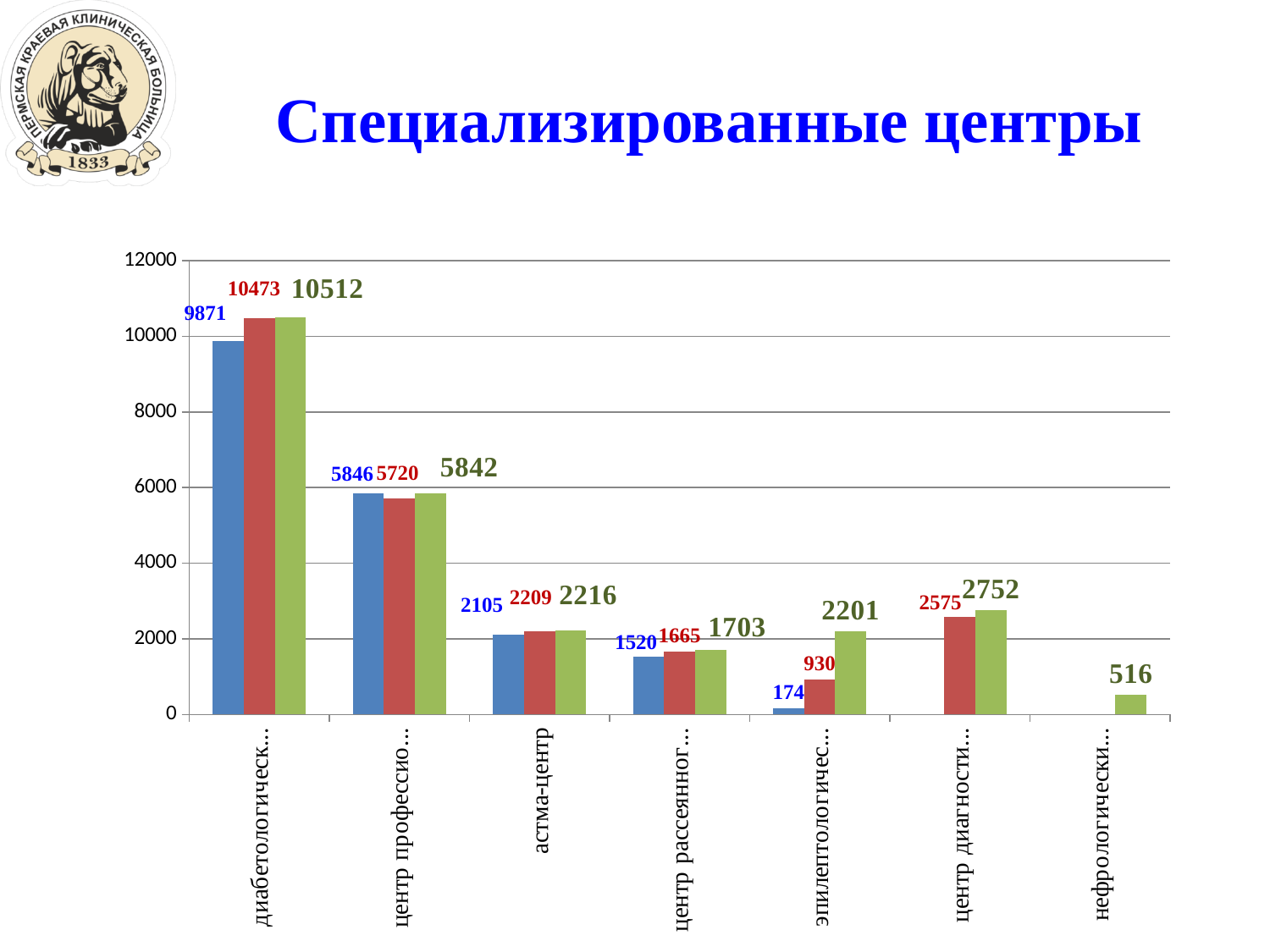
How many categories are shown along the x axis of the chart? 7 What is the lowest value labelled on the chart? 174 What is the value of the red bar for астма-центр? 2209 What is the title of the slide containing the chart? Специализированные центры What is the value of the only bar in the rightmost category of the chart? 516 Is the value of the green bar for астма-центр greater or less than 2000? greater What is the difference between the green bar and the blue bar for астма-центр? 111 For астма-центр, which is larger: the red bar or the blue bar? the red bar What is the value of the blue bar for астма-центр? 2105 What is the value of the green bar for астма-центр? 2216 What is the highest value labelled on the chart? 10512 What kind of chart is shown on the slide? bar chart